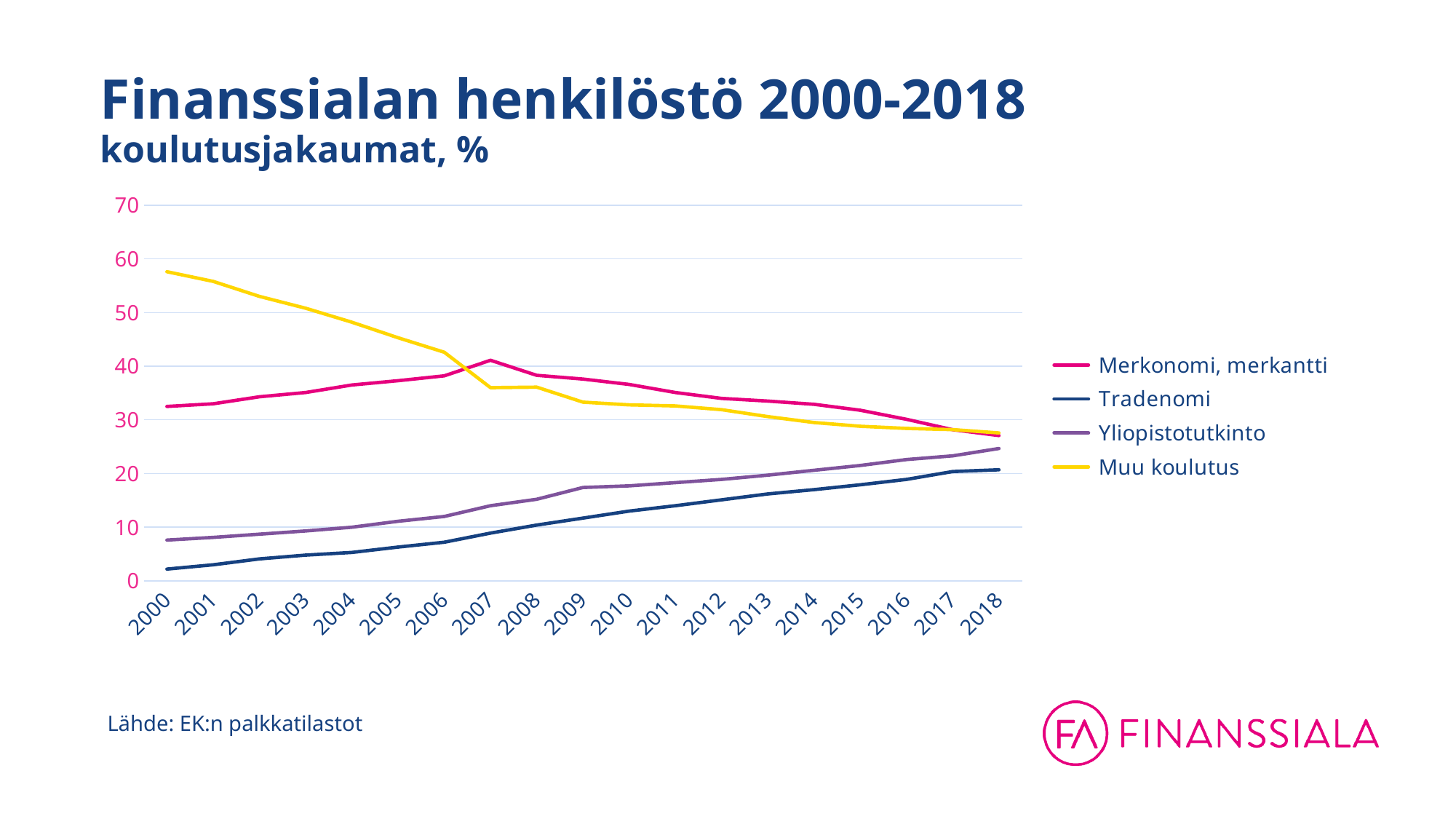
What is the source given at the bottom of the slide? EK:n palkkatilastot Is the value for Muu koulutus in 2000 greater or less than 50? greater Is the value for Tradenomi in 2000 greater or less than 10? less Is the value for Yliopistotutkinto in 2018 greater or less than 20? greater Which series has the highest value in 2000? Muu koulutus Does the Muu koulutus line rise or fall from 2000 to 2018? fall Does the Tradenomi line rise or fall from 2000 to 2018? rise How many years are shown on the x axis? 19 In 2018, which is larger: Yliopistotutkinto or Tradenomi? Yliopistotutkinto What kind of chart is shown on the slide? line chart Which series has the lowest value in 2000? Tradenomi How many series does the legend list? 4